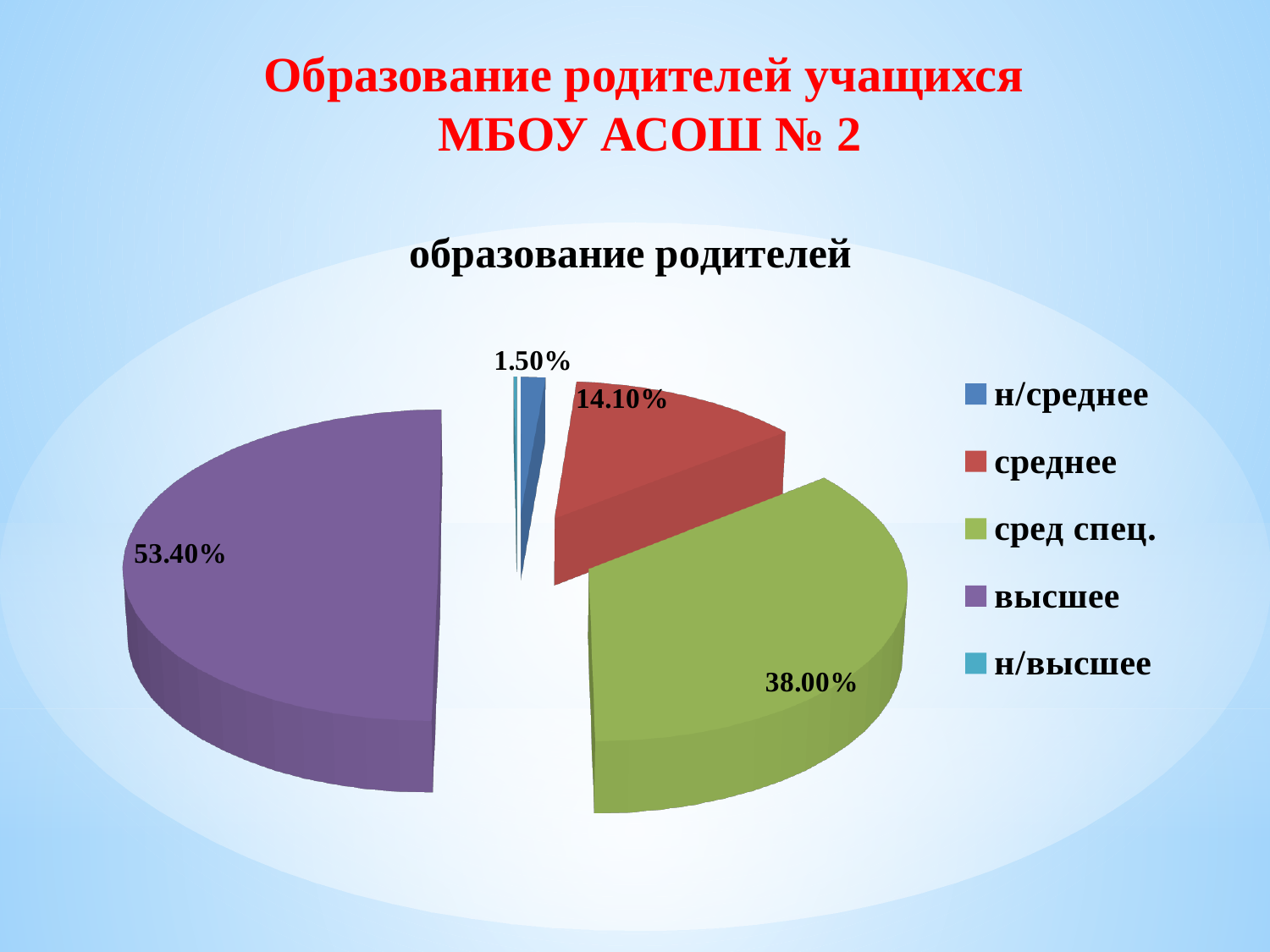
What percentage is shown for "н/среднее"? 1.50% What is the difference between the shares of "сред спец." and "среднее"? 23.90% How many categories does the legend list? 5 What share of the pie does the "высшее" category have? 53.40% What percentage is shown for "сред спец."? 38.00% What percentage is shown for "среднее"? 14.10% What is the difference between the shares of "высшее" and "сред спец."? 15.40% Which colour represents "высшее" in the chart? purple What kind of chart is shown on the slide? pie chart Which is larger, the share for "среднее" or the share for "сред спец."? сред спец. Which category has the largest share of the pie? высшее What is the title of the chart? образование родителей